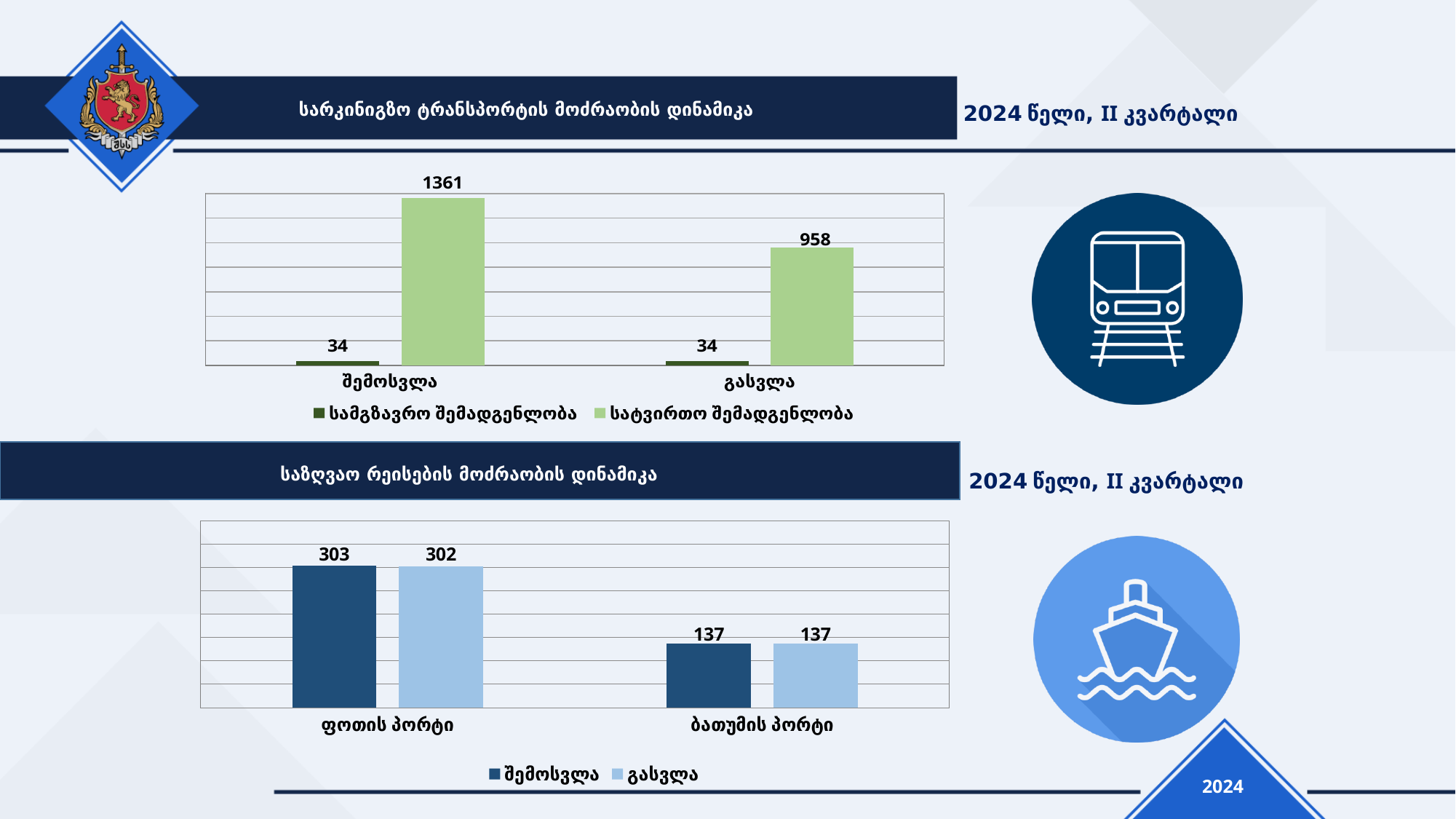
In the bottom chart (საზღვაო რეისების მოძრაობის დინამიკა), what is the შემოსვლა value for ფოთის პორტი? 303 In the bottom chart (საზღვაო რეისების მოძრაობის დინამიკა), which port has the larger გასვლა value, ფოთის პორტი or ბათუმის პორტი? ფოთის პორტი How many series does the legend of the top chart (სარკინიგზო ტრანსპორტის მოძრაობის დინამიკა) list? 2 In the top chart (სარკინიგზო ტრანსპორტის მოძრაობის დინამიკა), what is the value of სატვირთო შემადგენლობა for გასვლა? 958 In the top chart (სარკინიგზო ტრანსპორტის მოძრაობის დინამიკა), which category has the highest სატვირთო შემადგენლობა value? შემოსვლა In the top chart (სარკინიგზო ტრანსპორტის მოძრაობის დინამიკა), what is the value of სამგზავრო შემადგენლობა for შემოსვლა? 34 In the top chart (სარკინიგზო ტრანსპორტის მოძრაობის დინამიკა), what is the value of სატვირთო შემადგენლობა for შემოსვლა? 1361 How many categories are shown on the x axis of the bottom chart (საზღვაო რეისების მოძრაობის დინამიკა)? 2 In the bottom chart (საზღვაო რეისების მოძრაობის დინამიკა), what is the difference between the შემოსვლა values for ფოთის პორტი and ბათუმის პორტი? 166 In the top chart (სარკინიგზო ტრანსპორტის მოძრაობის დინამიკა), what is the difference between the სატვირთო შემადგენლობა values for შემოსვლა and გასვლა? 403 What type of chart is the bottom chart (საზღვაო რეისების მოძრაობის დინამიკა)? bar chart In the bottom chart (საზღვაო რეისების მოძრაობის დინამიკა), what is the გასვლა value for ბათუმის პორტი? 137